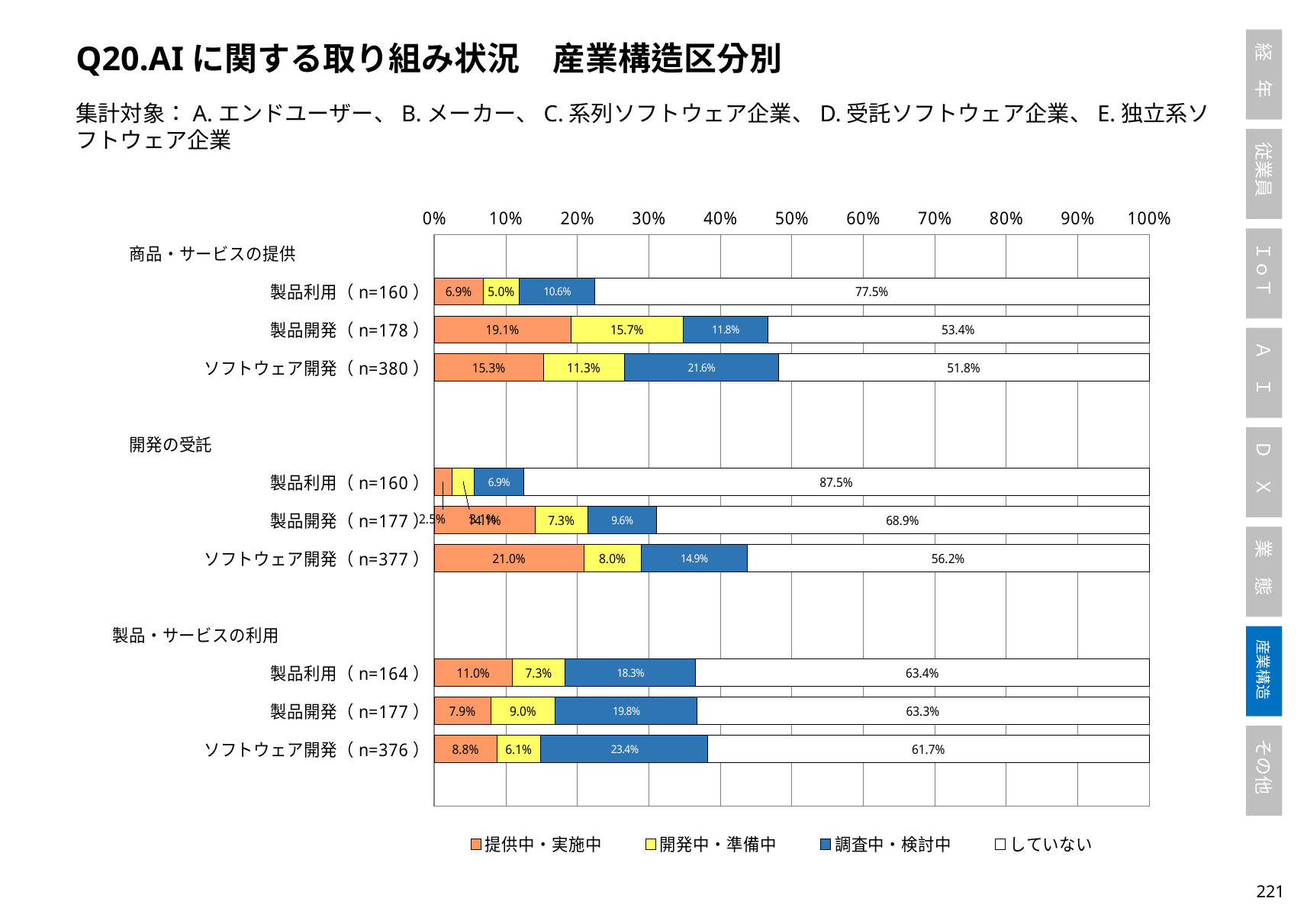
In the 製品・サービスの利用 group, what is the value of 開発中・準備中 for 製品開発 (n=177)? 9.0% How many series does the legend list? 4 Which bar has the highest value for していない? 開発の受託 製品利用 (n=160) Which legend entry is shown in blue? 調査中・検討中 In the 商品・サービスの提供 group, what is the value of 提供中・実施中 for 製品開発 (n=178)? 19.1% In the 開発の受託 group, what is the value of 調査中・検討中 for ソフトウェア開発 (n=377)? 14.9% In the 商品・サービスの提供 group, what is the value of していない for 製品利用 (n=160)? 77.5% What kind of chart is shown on the slide? Stacked bar chart Which bar has the lowest value for していない? 商品・サービスの提供 ソフトウェア開発 (n=380) How many bars are plotted in the chart? 9 In the 製品・サービスの利用 group, what is the difference between the 調査中・検討中 values for ソフトウェア開発 (n=376) and 製品利用 (n=164)? 5.1% Which is larger: the 提供中・実施中 value for 開発の受託 ソフトウェア開発 (n=377) or for 商品・サービスの提供 ソフトウェア開発 (n=380)? 開発の受託 ソフトウェア開発 (n=377)